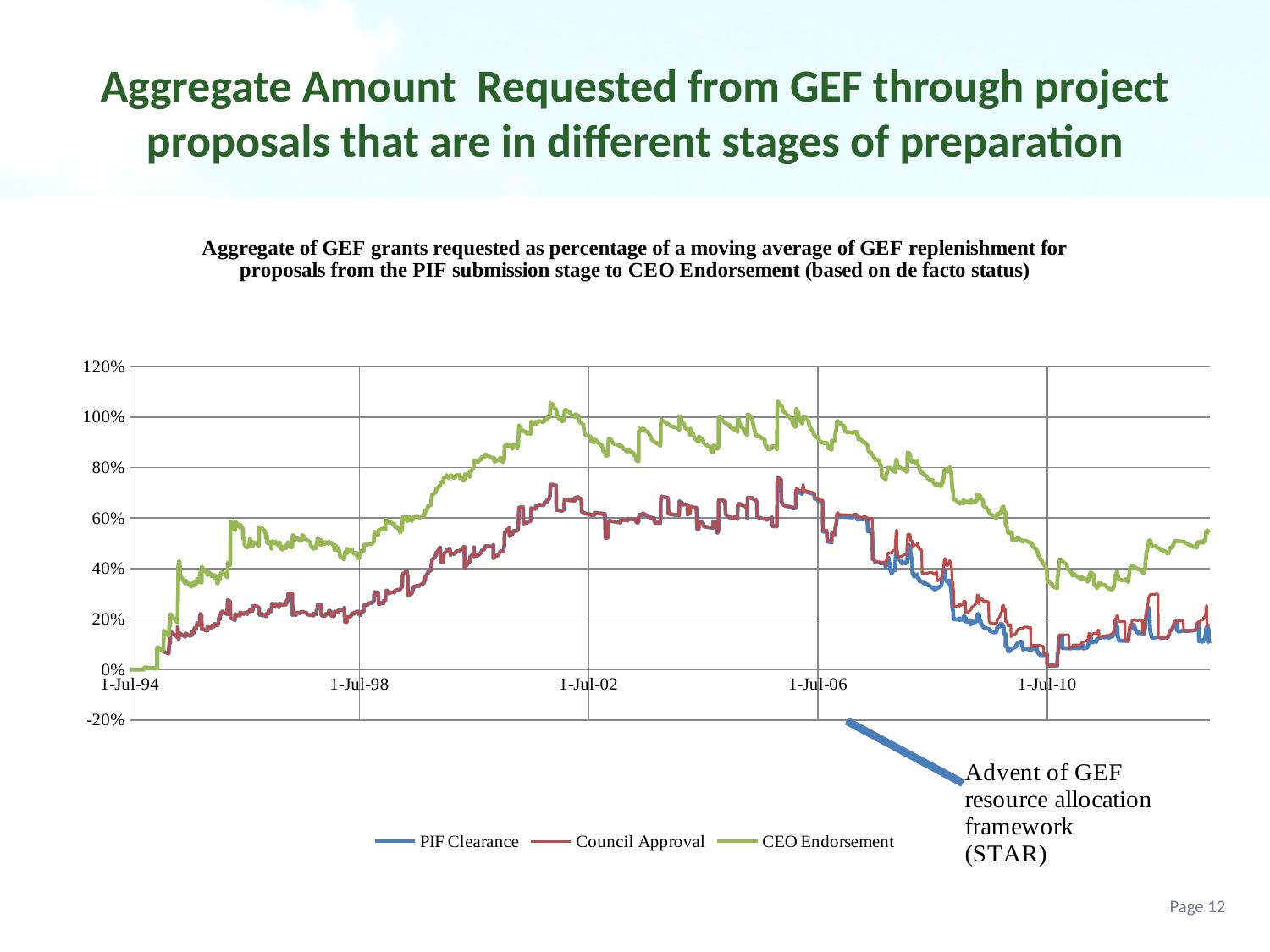
Is the value for CEO Endorsement at 1-Jul-10 greater or less than 60%? less Is the value for PIF Clearance at 1-Jul-10 greater or less than 20%? less What kind of chart is shown on the slide? line chart Is the value for Council Approval at 1-Jul-02 greater or less than 40%? greater What are the three series named in the legend? PIF Clearance, Council Approval, CEO Endorsement How many series does the legend list? 3 Does the CEO Endorsement line rise or fall between 1-Jul-06 and 1-Jul-10? fall At 1-Jul-02, which is larger: CEO Endorsement or Council Approval? CEO Endorsement Which series reaches the highest value on the chart? CEO Endorsement What colour is the CEO Endorsement line? green How many date labels are shown on the x axis? 5